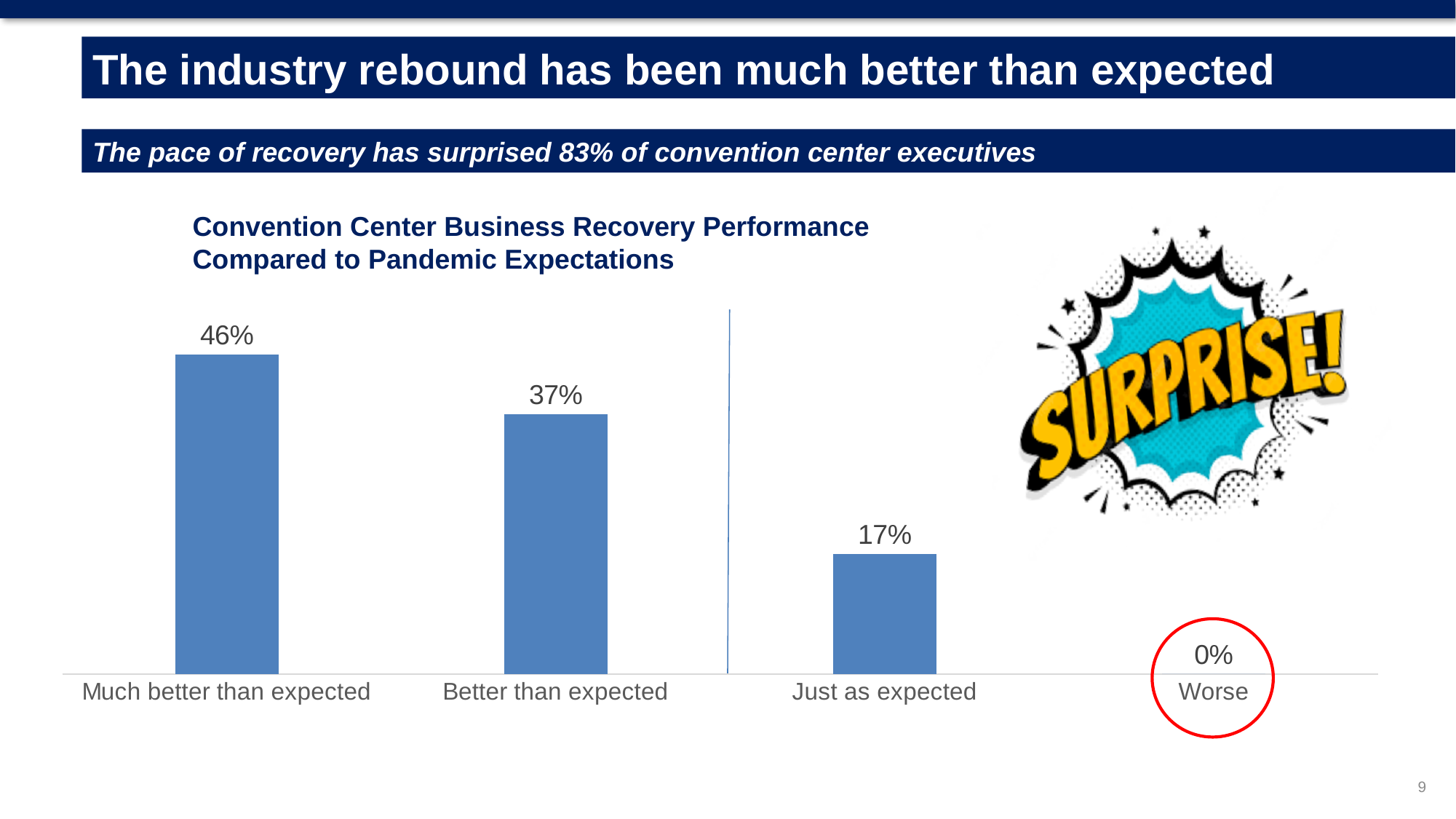
What is the value for the 'Just as expected' category? 17% What is the difference between the 'Better than expected' and 'Just as expected' values? 20 percentage points Which category has the highest value? Much better than expected What percentage of convention center executives said business recovery was much better than expected? 46% What is the difference between the 'Much better than expected' and 'Better than expected' values? 9 percentage points What is the title of the chart? Convention Center Business Recovery Performance Compared to Pandemic Expectations What is the value for the 'Better than expected' category? 37% Which is larger, the value for 'Better than expected' or the value for 'Just as expected'? Better than expected How many categories are shown in the chart? 4 What kind of chart is shown on the slide? Bar chart What is the value for the 'Worse' category? 0% Which category has the lowest value? Worse